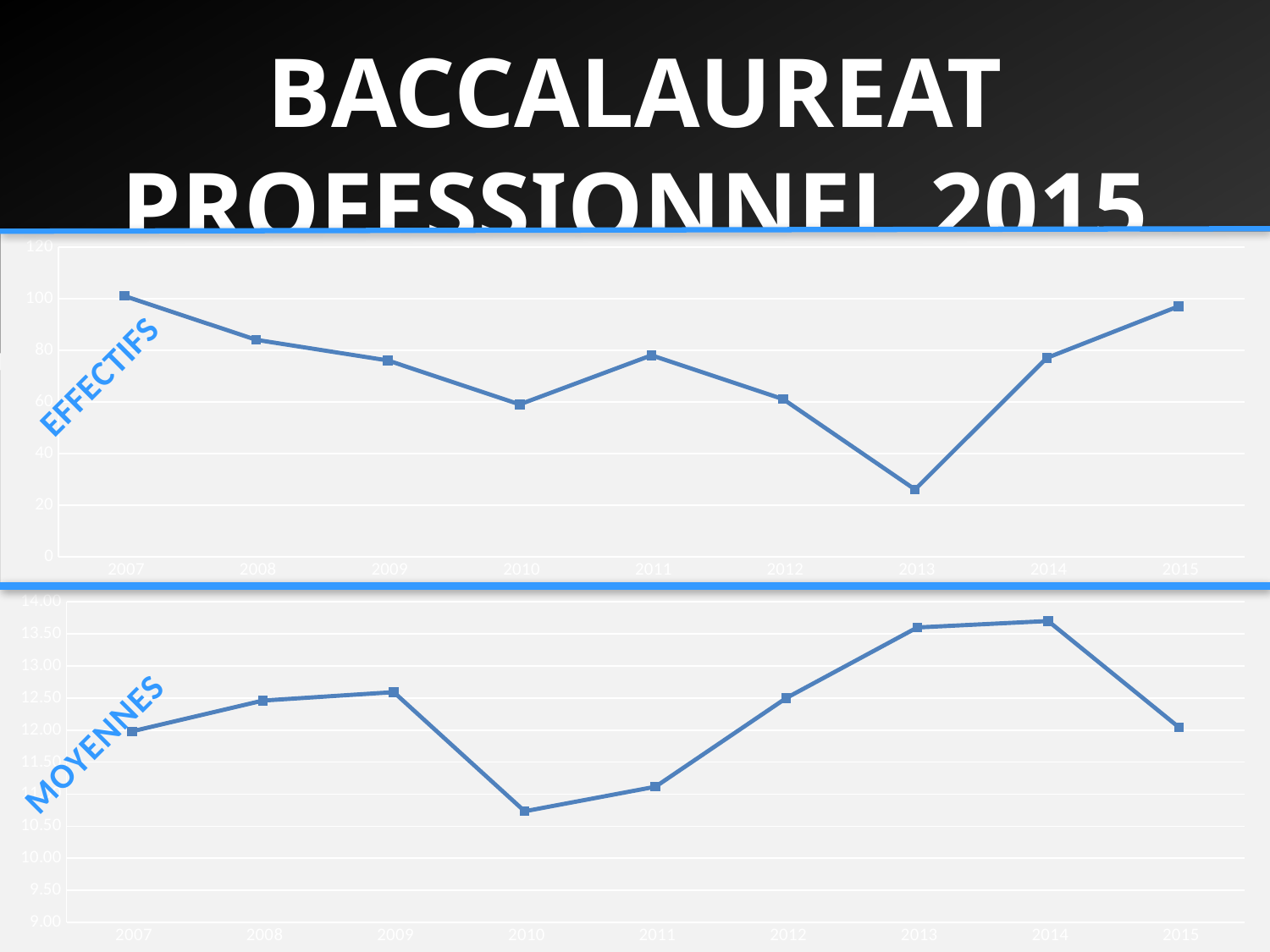
In the EFFECTIFS chart, do the values rise or fall from 2013 to 2015? rise In the EFFECTIFS chart, is the value for 2015 greater or less than 80? greater In the EFFECTIFS chart, which year has the lowest value? 2013 In the MOYENNES chart, which year has the larger value, 2013 or 2015? 2013 How many years are plotted on the x axis of the EFFECTIFS chart? 9 What kind of chart is the top chart labelled EFFECTIFS? line chart What are the labels of the two charts on the slide? EFFECTIFS and MOYENNES In the EFFECTIFS chart, which year has the highest value? 2007 In the EFFECTIFS chart, which year has the larger value, 2008 or 2012? 2008 In the MOYENNES chart, which year has the lowest value? 2010 In the MOYENNES chart, is the value for 2010 greater or less than 11.00? less In the EFFECTIFS chart, is the value for 2013 greater or less than 40? less